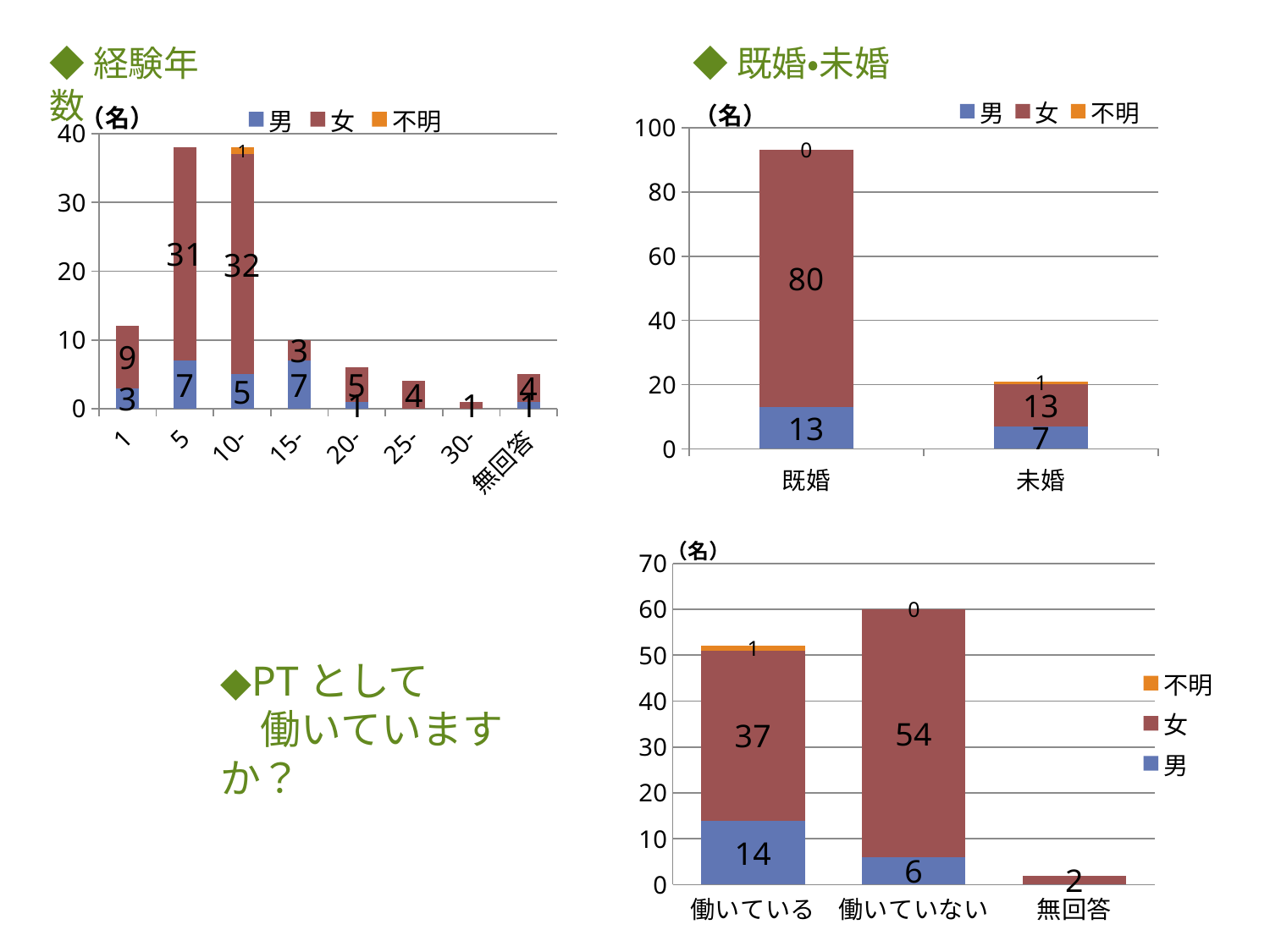
In the PTとして働いていますか？ chart, what is the value for 女 in the 働いていない category? 54 In the 経験年数 chart, how many categories are shown on the x axis? 8 In the 既婚・未婚 chart, what is the difference between the 女 values for 既婚 and 未婚? 67 In the PTとして働いていますか？ chart, which is larger, the 男 value for 働いている or for 働いていない? 働いている In the PTとして働いていますか？ chart, which category has the lowest total? 無回答 In the 既婚・未婚 chart, what is the total of the stacked bar for 既婚? 93 In the PTとして働いていますか？ chart, what is the total of the stacked bar for 働いている? 52 In the 経験年数 chart, what is the value for 女 in the 5 category? 31 In the 既婚・未婚 chart, what is the value for 女 in the 既婚 category? 80 In the 経験年数 chart, which category has the highest total? 5 and 10- (tied at 38) How many series does the legend of the 経験年数 chart list? 3 In the 既婚・未婚 chart, what is the value for 男 in the 未婚 category? 7